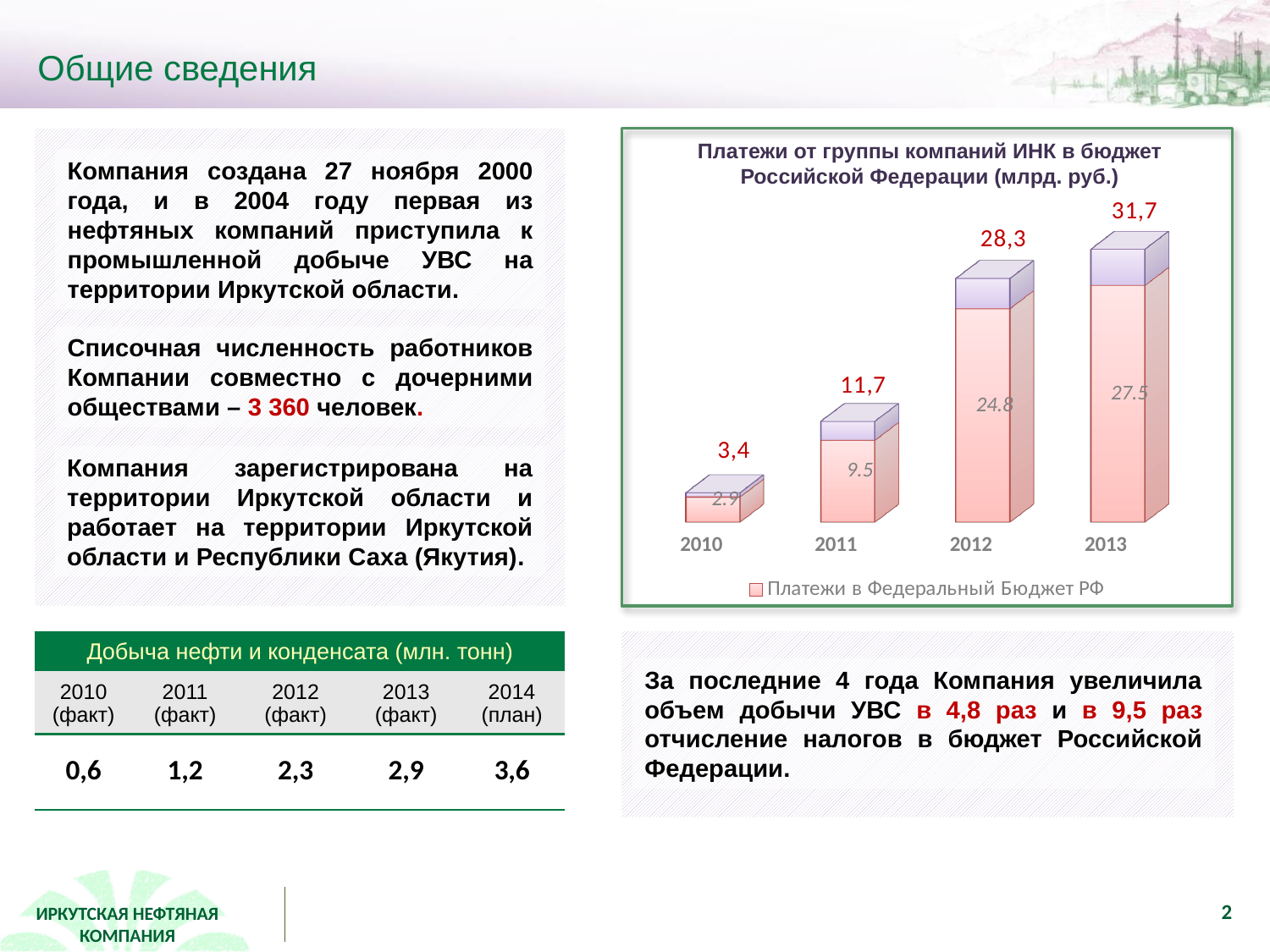
What is the difference between the total payments in 2013 and 2012? 3,4 Do the total payments rise or fall from 2010 to 2013? Rise Which year has the highest total payments in the chart? 2013 Which year has larger total payments, 2011 or 2012? 2012 Which year has the lowest total payments in the chart? 2010 What is the total value shown above the 2013 bar in the chart? 31,7 What value is printed inside the 2011 bar for payments to the Federal Budget of the RF? 9.5 What is the total value shown above the 2010 bar in the chart? 3,4 What kind of chart is used to show the payments to the budget of the Russian Federation? Bar chart What value is printed inside the 2012 bar for payments to the Federal Budget of the RF? 24.8 How many years are shown on the x axis of the chart? 4 What is the difference between the total payments in 2012 and 2011? 16,6